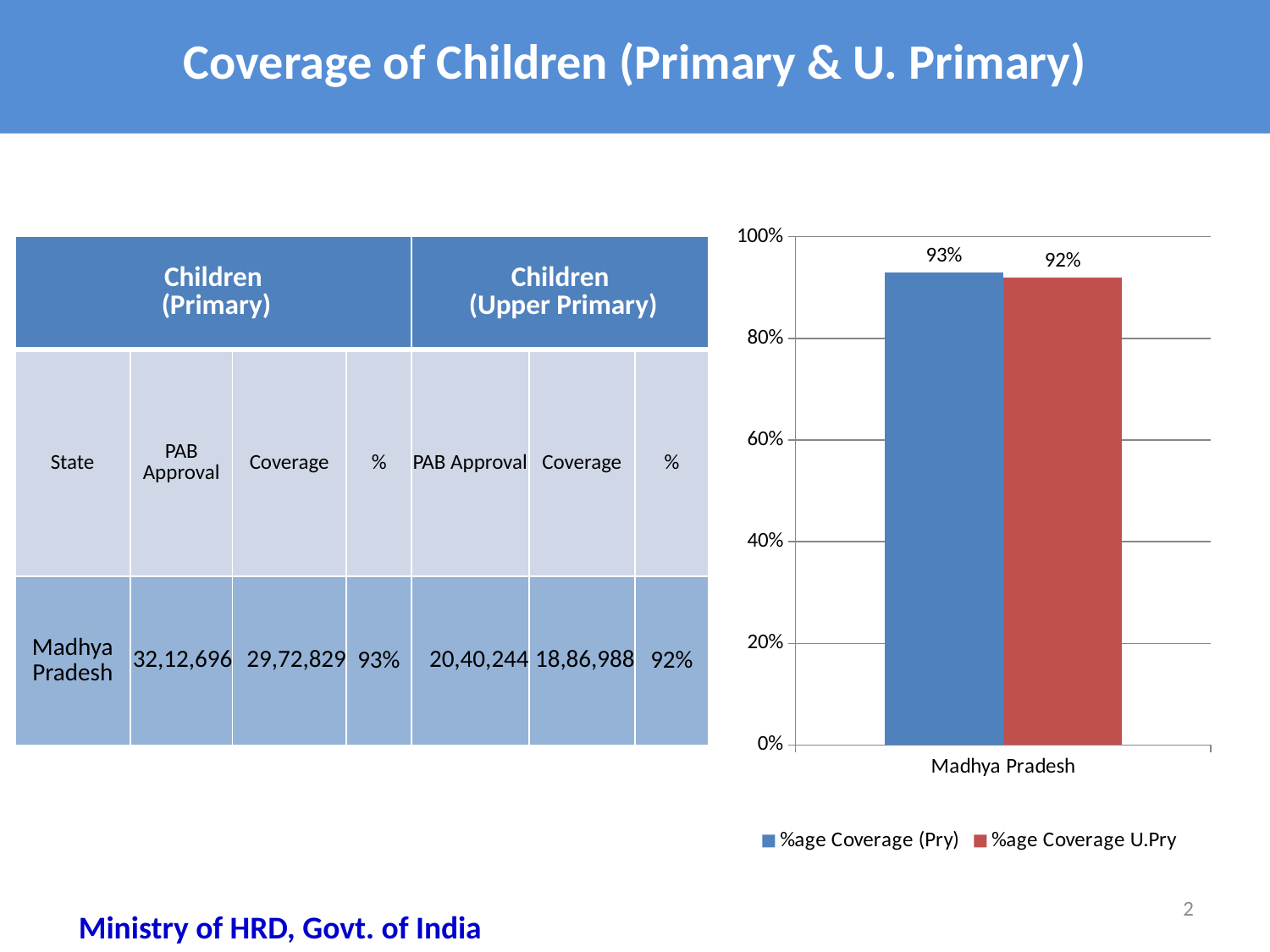
Is the value for %age Coverage U.Pry for Madhya Pradesh greater or less than 80%? greater What is the value of %age Coverage (Pry) for Madhya Pradesh in the chart? 93% What colour is the bar for %age Coverage U.Pry in the chart? red What is the maximum value shown on the y axis of the chart? 100% What is the difference between %age Coverage (Pry) and %age Coverage U.Pry for Madhya Pradesh? 1% Is the value for %age Coverage (Pry) for Madhya Pradesh greater or less than 100%? less What is the value of %age Coverage U.Pry for Madhya Pradesh in the chart? 92% Which category is shown on the x axis of the chart? Madhya Pradesh Which series has the higher value for Madhya Pradesh, %age Coverage (Pry) or %age Coverage U.Pry? %age Coverage (Pry) What kind of chart is shown on the slide? bar chart How many series does the chart legend list? 2 How many categories are shown on the x axis of the chart? 1